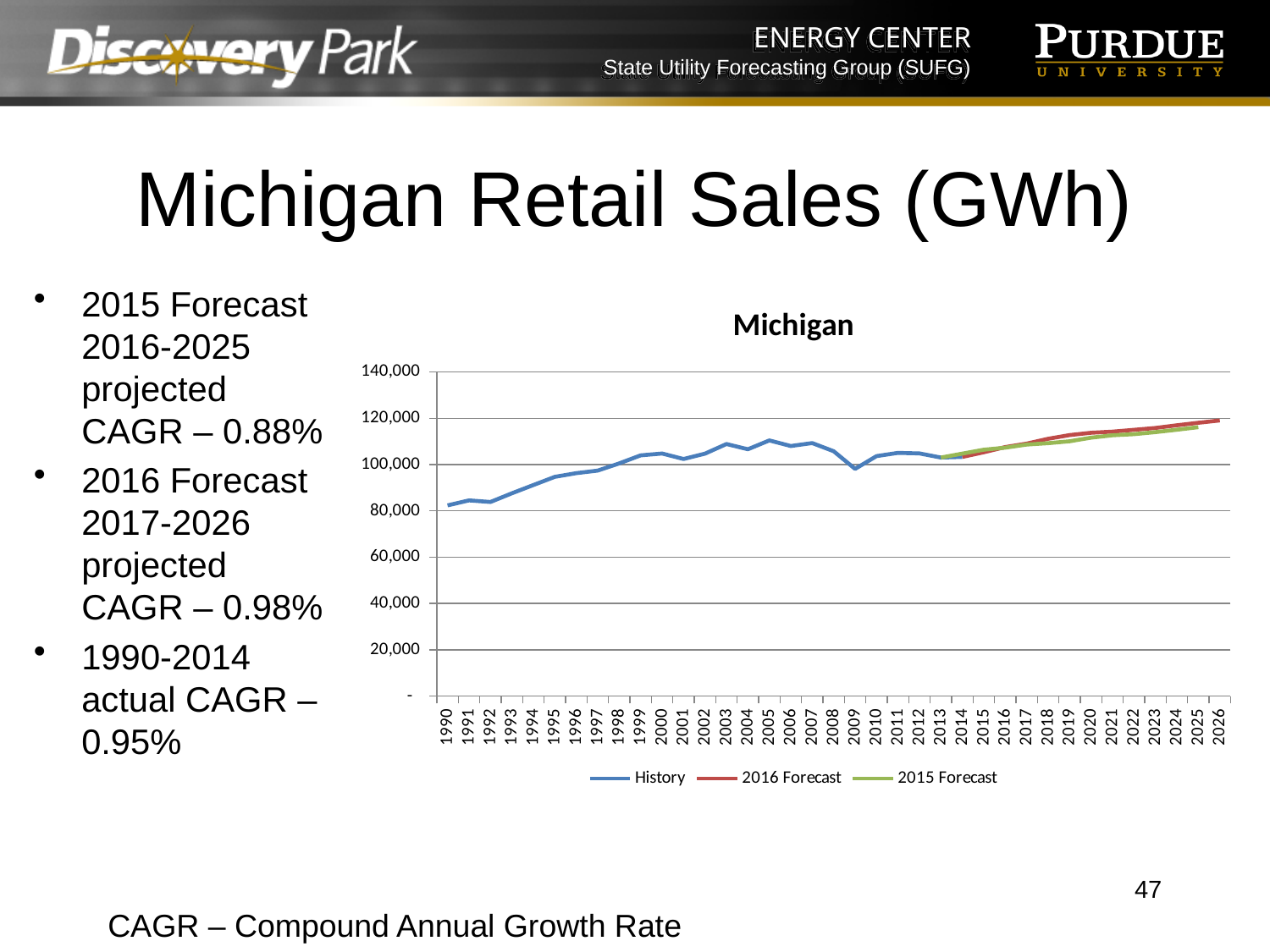
What kind of chart is shown on the slide? line chart How many years are labelled on the x axis of the chart? 37 How many series does the chart legend list? 3 Does the 2016 Forecast series rise or fall from 2014 to 2026? rise Is the History value for 2005 greater or less than 100,000? greater Is the 2015 Forecast value for 2025 greater or less than 140,000? less Is the 2016 Forecast value for 2026 greater or less than 100,000? greater Does the History series rise or fall from 1990 to 2000? rise Which series is drawn in blue in the chart? History What is the title of the chart? Michigan